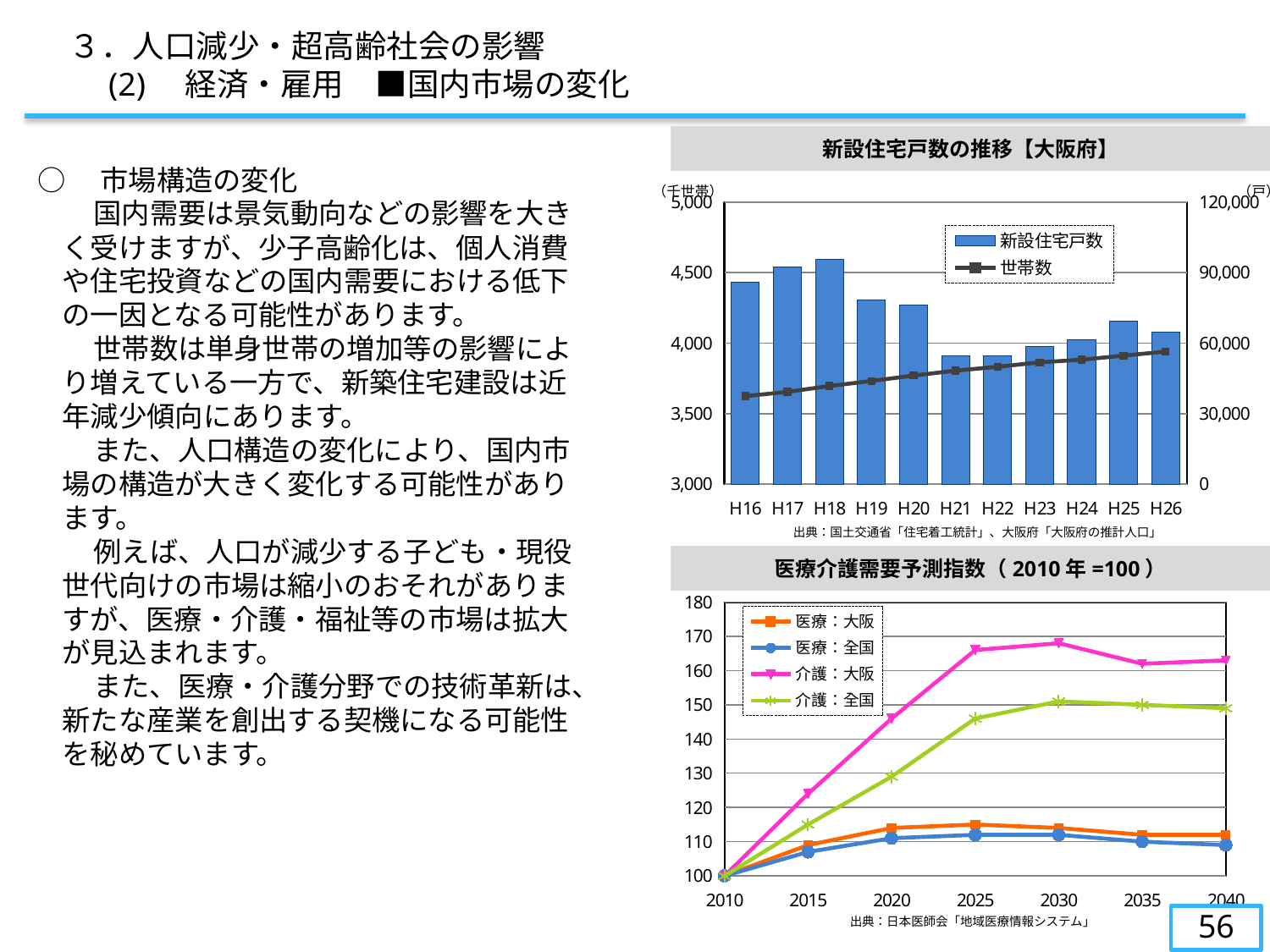
In the top chart titled 新設住宅戸数の推移【大阪府】, which is larger, the 新設住宅戸数 bar for H18 or for H26? H18 In the top chart titled 新設住宅戸数の推移【大阪府】, does the 世帯数 line rise or fall from H16 to H26? rise In the bottom chart titled 医療介護需要予測指数, how many series does the legend list? 4 What kind of chart is the bottom chart titled 医療介護需要予測指数? line chart In the top chart titled 新設住宅戸数の推移【大阪府】, how many years are shown on the x axis? 11 In the top chart titled 新設住宅戸数の推移【大阪府】, which year has the highest 新設住宅戸数 bar? H18 In the bottom chart titled 医療介護需要予測指数, which series has the highest value in 2030? 介護：大阪 In the top chart titled 新設住宅戸数の推移【大阪府】, is the 新設住宅戸数 value for H16 greater or less than 4,000? greater In the bottom chart titled 医療介護需要予測指数, is the value for 介護：大阪 in 2025 greater or less than 160? greater In the top chart titled 新設住宅戸数の推移【大阪府】, how many series does the legend list? 2 In the bottom chart titled 医療介護需要予測指数, what is the value of all series in 2010? 100